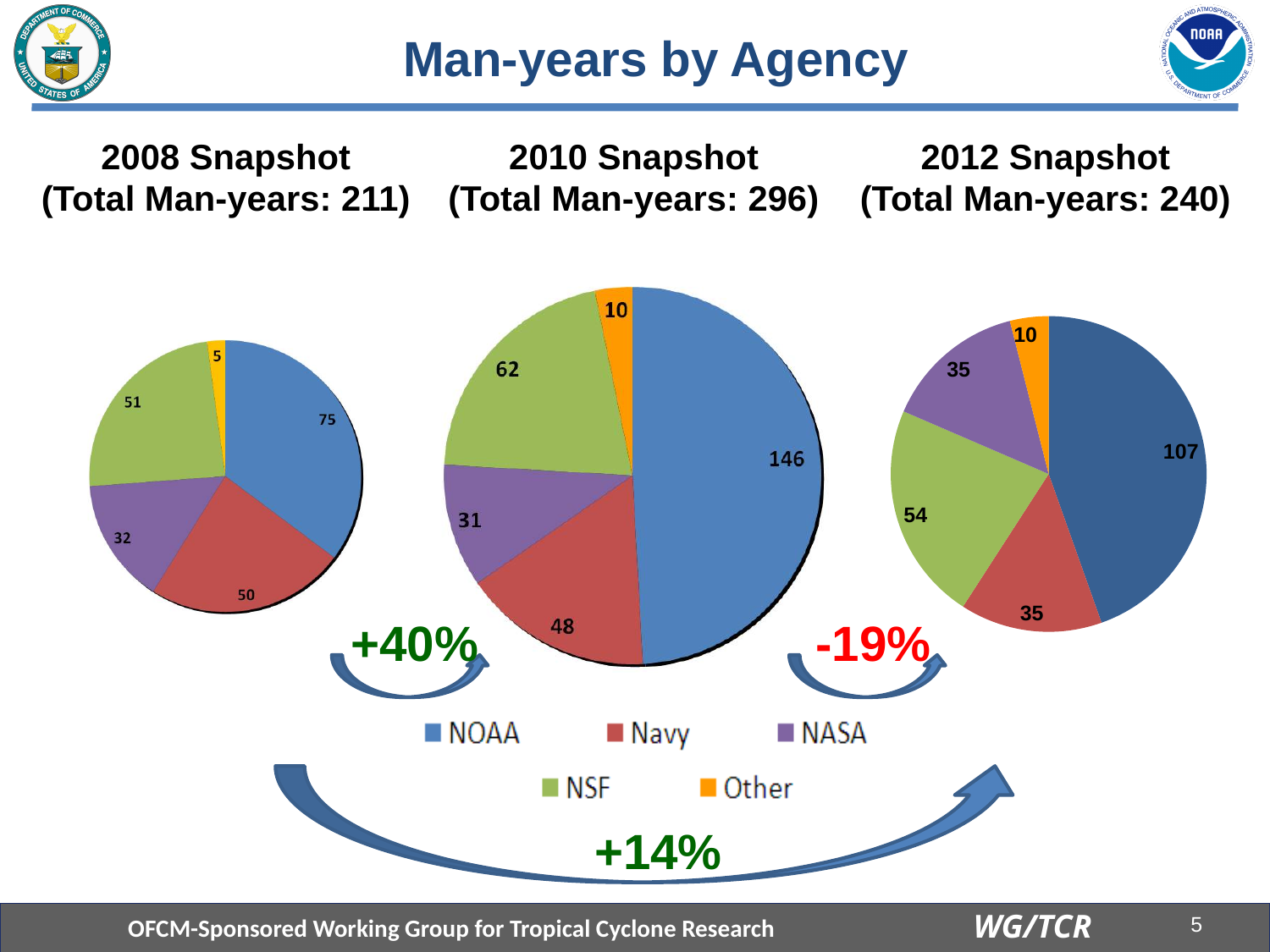
In the 2010 Snapshot pie chart, what is the value for NSF? 62 What percentage change is shown between the 2010 Snapshot and the 2012 Snapshot? -19% In the 2008 Snapshot pie chart, what is the value for NOAA? 75 In the 2008 Snapshot pie chart, which category has the smallest slice? Other What kind of chart is used for the 2008 Snapshot? Pie chart How many entries does the shared legend list? 5 In the 2012 Snapshot pie chart, what is the difference between the NOAA value and the NSF value? 53 How many slices does the 2012 Snapshot pie chart have? 5 In the 2010 Snapshot pie chart, which is larger, the Navy slice or the NASA slice? Navy In the 2012 Snapshot pie chart, what is the value for NASA? 35 What is the total man-years stated for the 2010 Snapshot? 296 In the 2010 Snapshot pie chart, which agency has the largest slice? NOAA